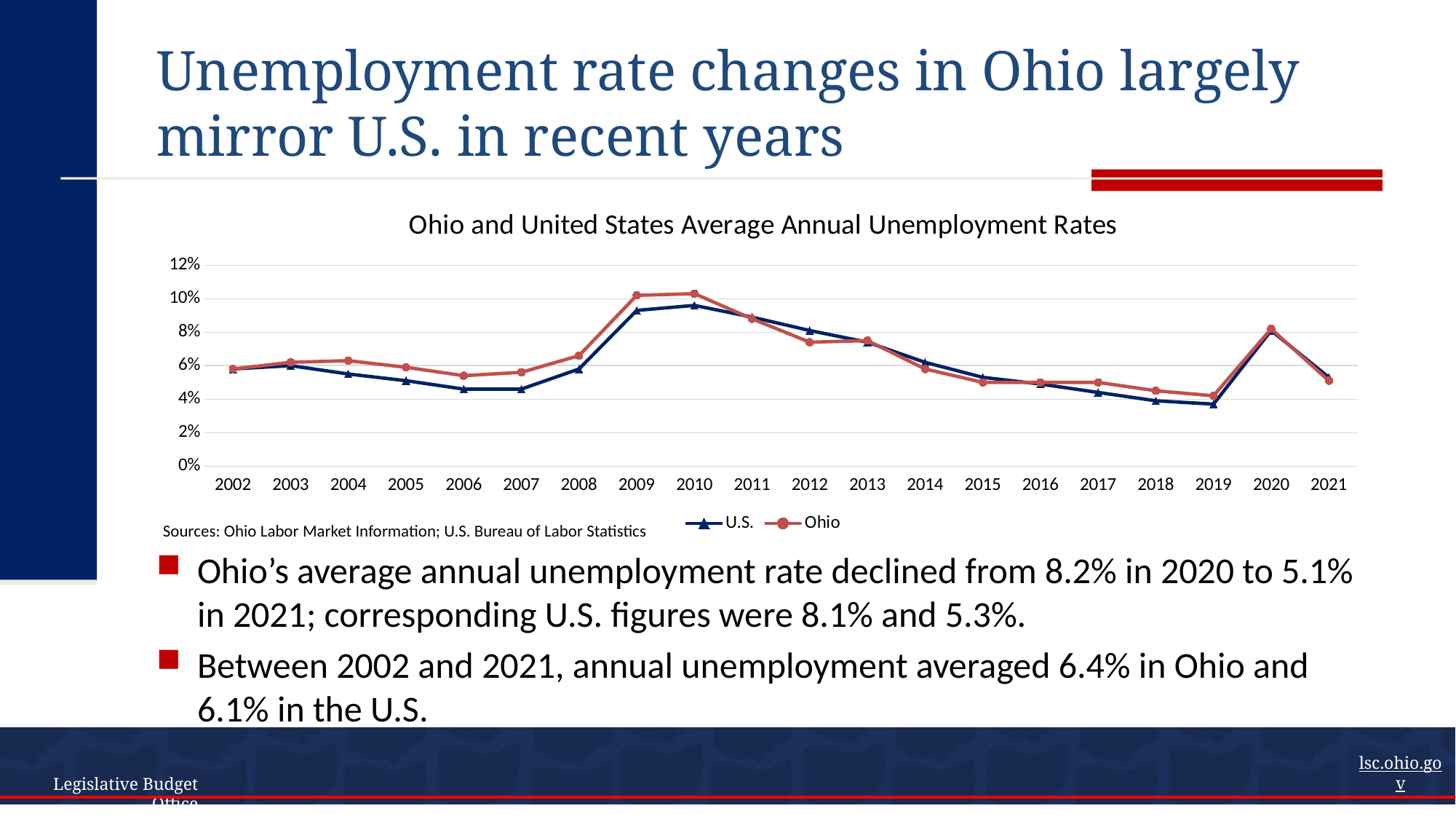
What was Ohio's average annual unemployment rate in 2020? 8.2% In 2009, which series has the higher unemployment rate, U.S. or Ohio? Ohio What was the U.S. average annual unemployment rate in 2021? 5.3% By how many percentage points did Ohio's unemployment rate decline from 2020 to 2021? 3.1 percentage points Does the Ohio unemployment rate rise or fall between 2010 and 2019? fall What type of chart is shown on the slide? line chart Is the U.S. unemployment rate for 2019 greater or less than 4%? less What was Ohio's average annual unemployment rate in 2021? 5.1% In 2012, which series has the higher unemployment rate, U.S. or Ohio? U.S. Is the U.S. unemployment rate for 2010 greater or less than 10%? less How many years are plotted along the x axis of the chart? 20 How many series does the chart legend list? 2